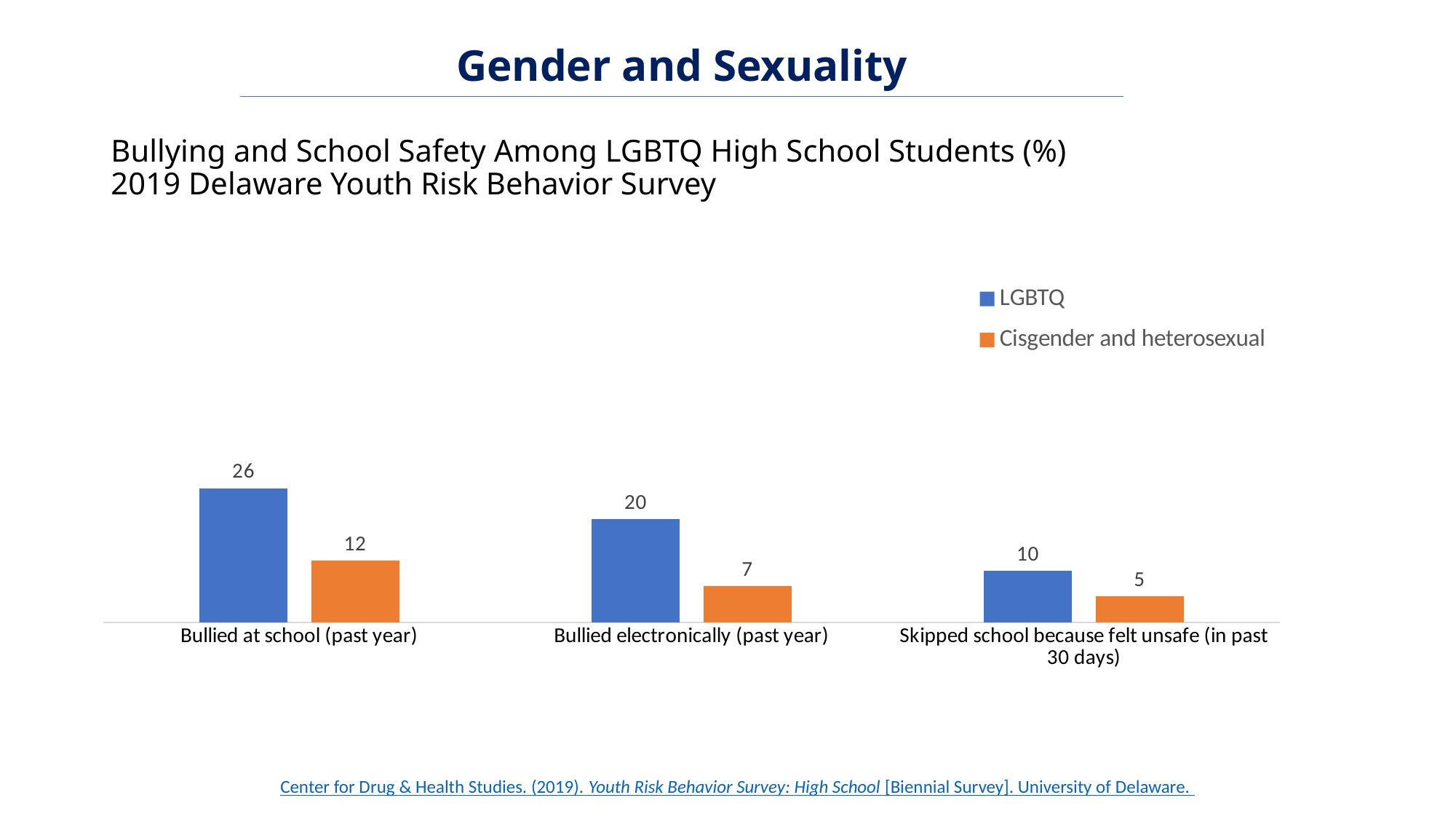
What is the LGBTQ value for Bullied at school (past year)? 26 How many categories are shown on the x axis? 3 What is the difference between the LGBTQ and Cisgender and heterosexual values for Bullied electronically (past year)? 13 Which category has the lowest Cisgender and heterosexual value? Skipped school because felt unsafe (in past 30 days) Which is larger: the LGBTQ value for Bullied electronically (past year) or the Cisgender and heterosexual value for Bullied at school (past year)? LGBTQ value for Bullied electronically (past year) How many series does the legend list? 2 What is the Cisgender and heterosexual value for Skipped school because felt unsafe (in past 30 days)? 5 Which category has the highest LGBTQ value? Bullied at school (past year) What is the difference between the LGBTQ and Cisgender and heterosexual values for Bullied at school (past year)? 14 What is the LGBTQ value for Skipped school because felt unsafe (in past 30 days)? 10 What kind of chart is shown on the slide? Bar chart What is the Cisgender and heterosexual value for Bullied electronically (past year)? 7